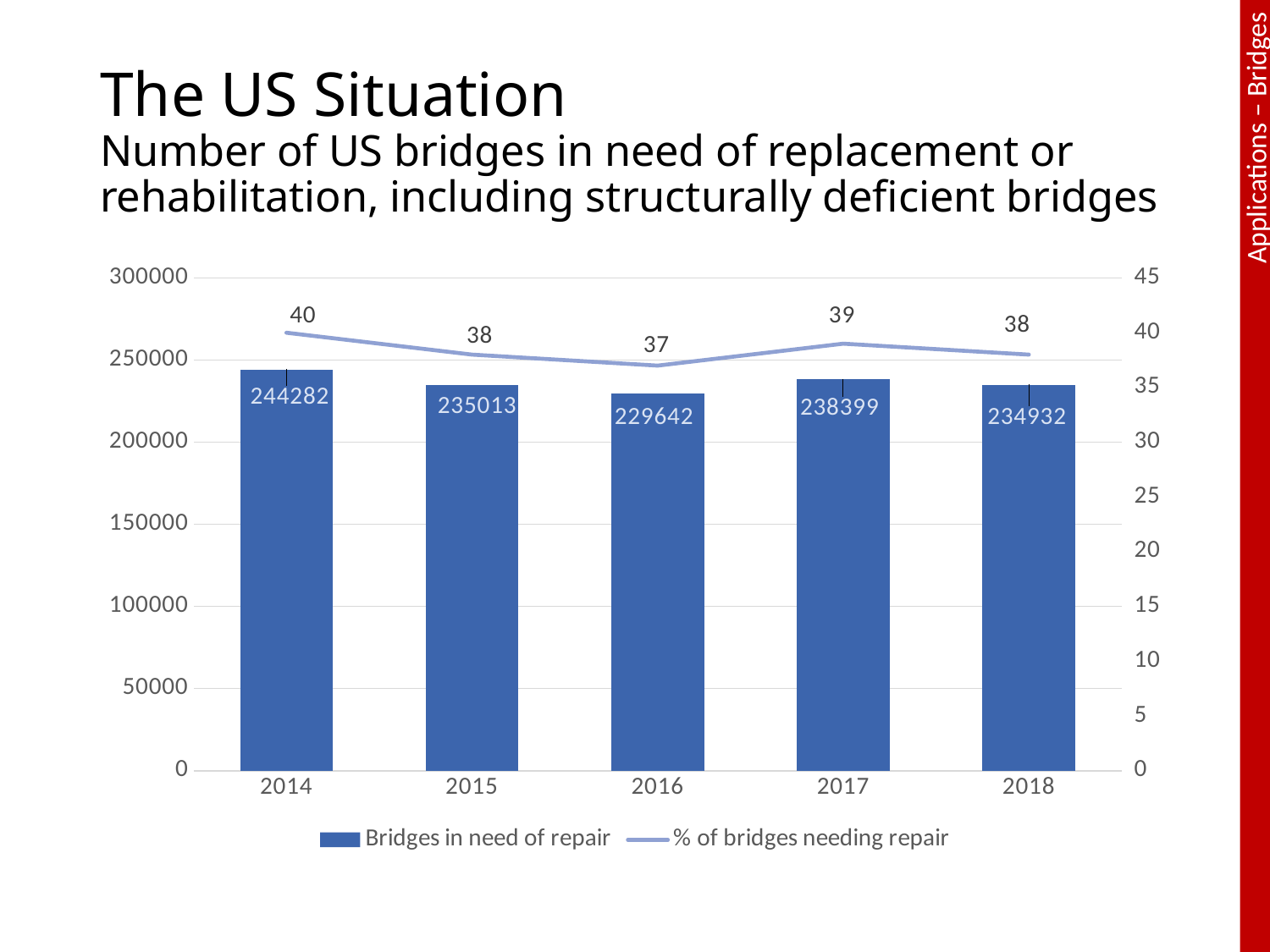
What is the difference in the number of bridges in need of repair between 2014 and 2016? 14640 What is the % of bridges needing repair in 2016? 37 What is the number of bridges in need of repair in 2016? 229642 Which year has the lowest number of bridges in need of repair? 2016 What kind of chart is used for the 'Bridges in need of repair' series? Bar chart Which year has the highest number of bridges in need of repair? 2014 How many series does the legend list? 2 How many years are shown on the x axis? 5 What is the number of bridges in need of repair in 2014? 244282 Which year has more bridges in need of repair, 2015 or 2017? 2017 Which series is shown as a line? % of bridges needing repair What is the % of bridges needing repair in 2017? 39